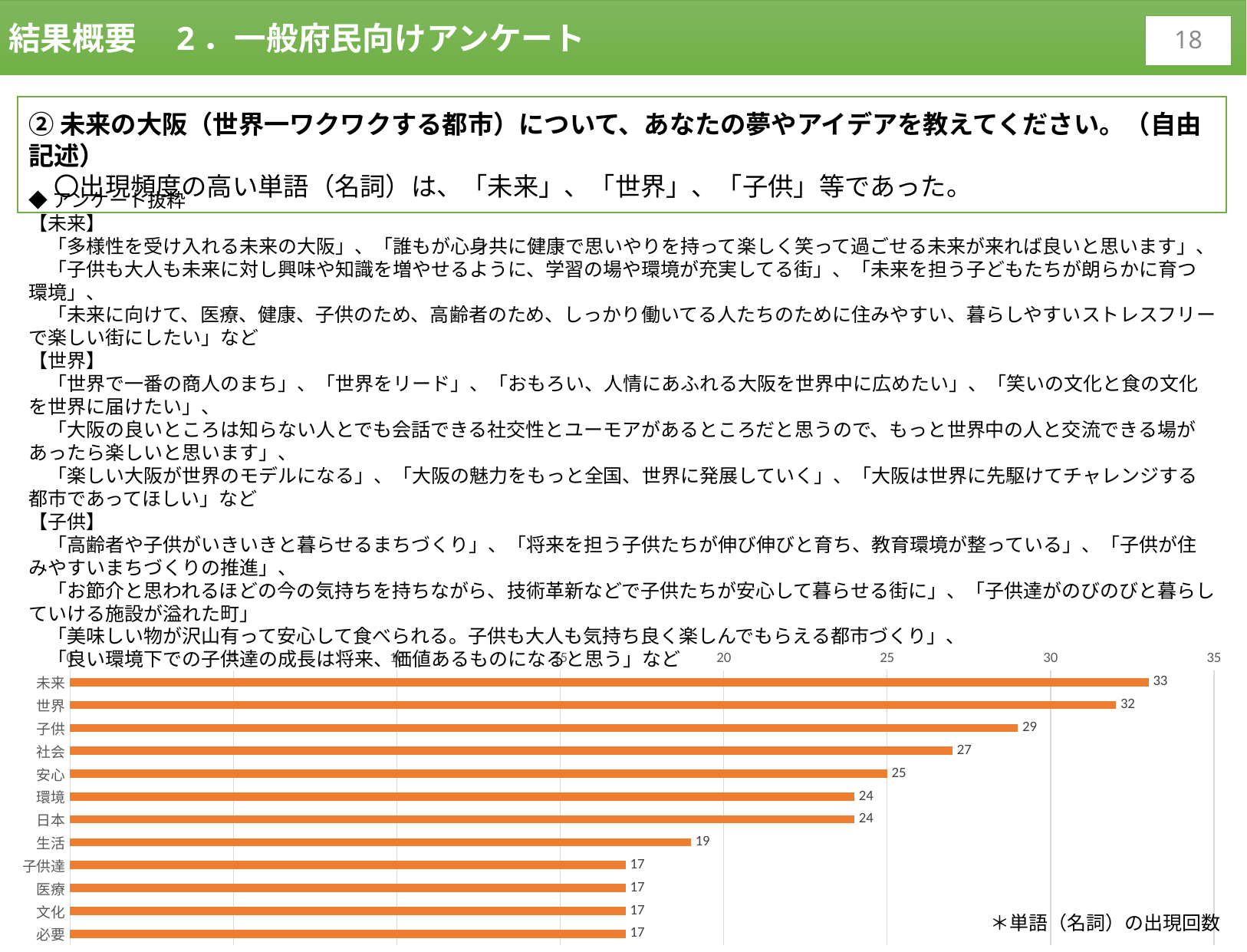
What is the maximum value shown on the chart's horizontal axis? 35 What is the value for 生活 in the bar chart? 19 What is the difference between the values for 子供 and 生活? 10 What is the value for 必要 in the bar chart? 17 Which is larger, the value for 安心 or the value for 環境? 安心 Which category has the highest value in the bar chart? 未来 What is the difference between the values for 未来 and 世界? 1 What is the value for 社会 in the bar chart? 27 Is the value for 子供 greater or less than 25? greater How many categories are shown in the bar chart? 12 What kind of chart is shown on the slide? bar chart What is the value for 未来 in the bar chart? 33